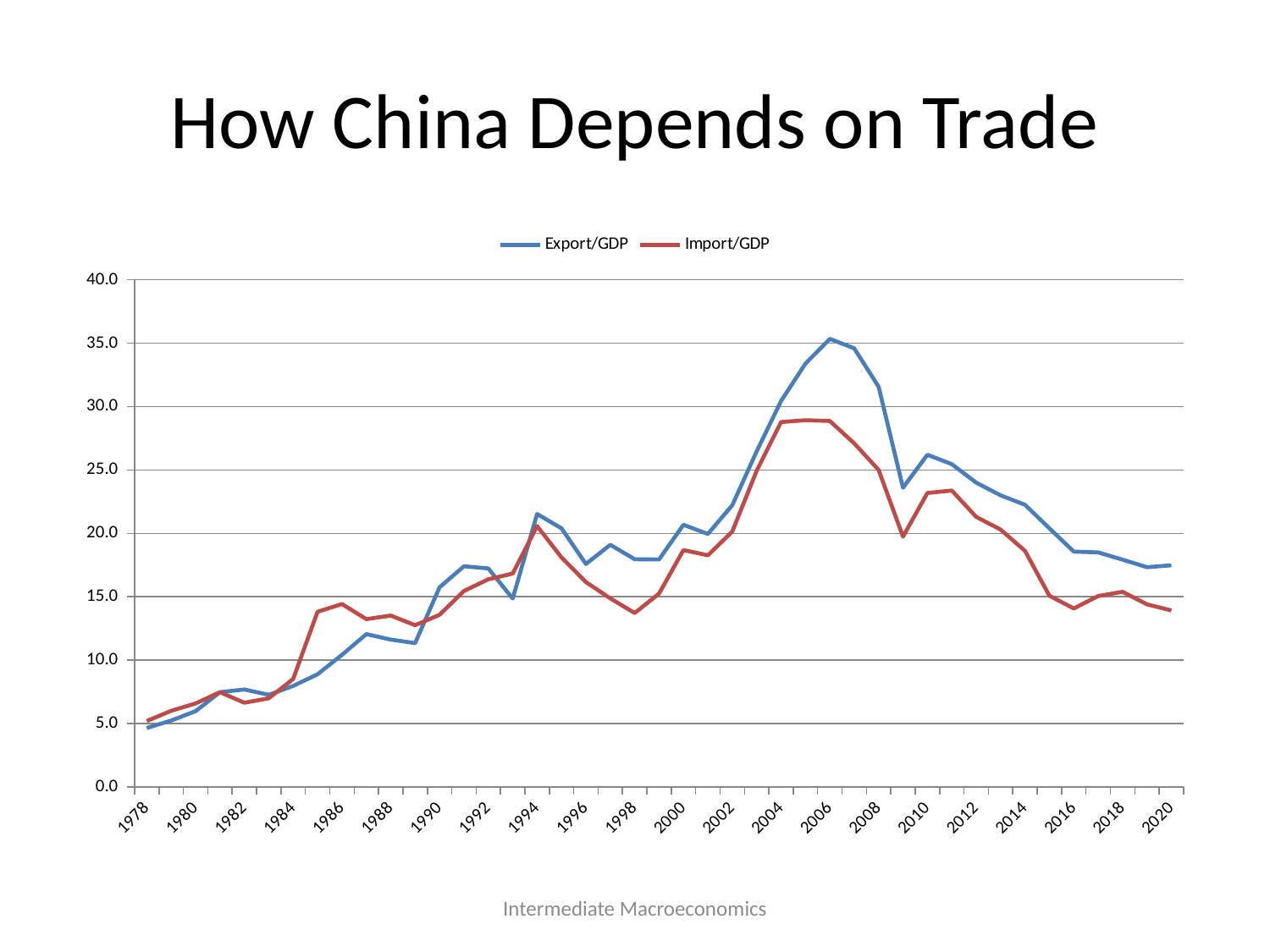
In 2006, which is higher, Export/GDP or Import/GDP? Export/GDP What kind of chart is shown on the slide? line chart What is the title of the chart? How China Depends on Trade In 1986, which is higher, Export/GDP or Import/GDP? Import/GDP What are the two series named in the legend? Export/GDP and Import/GDP Is the value for Import/GDP in 2020 greater or less than 15.0? less How many series does the legend list? 2 In which year does Export/GDP reach its highest value? 2006 Is the value for Import/GDP in 2009 greater or less than 25.0? less From 2006 to 2020, does Export/GDP generally rise or fall? fall In which year is Export/GDP at its lowest? 1978 Is the value for Export/GDP in 2006 greater or less than 30.0? greater